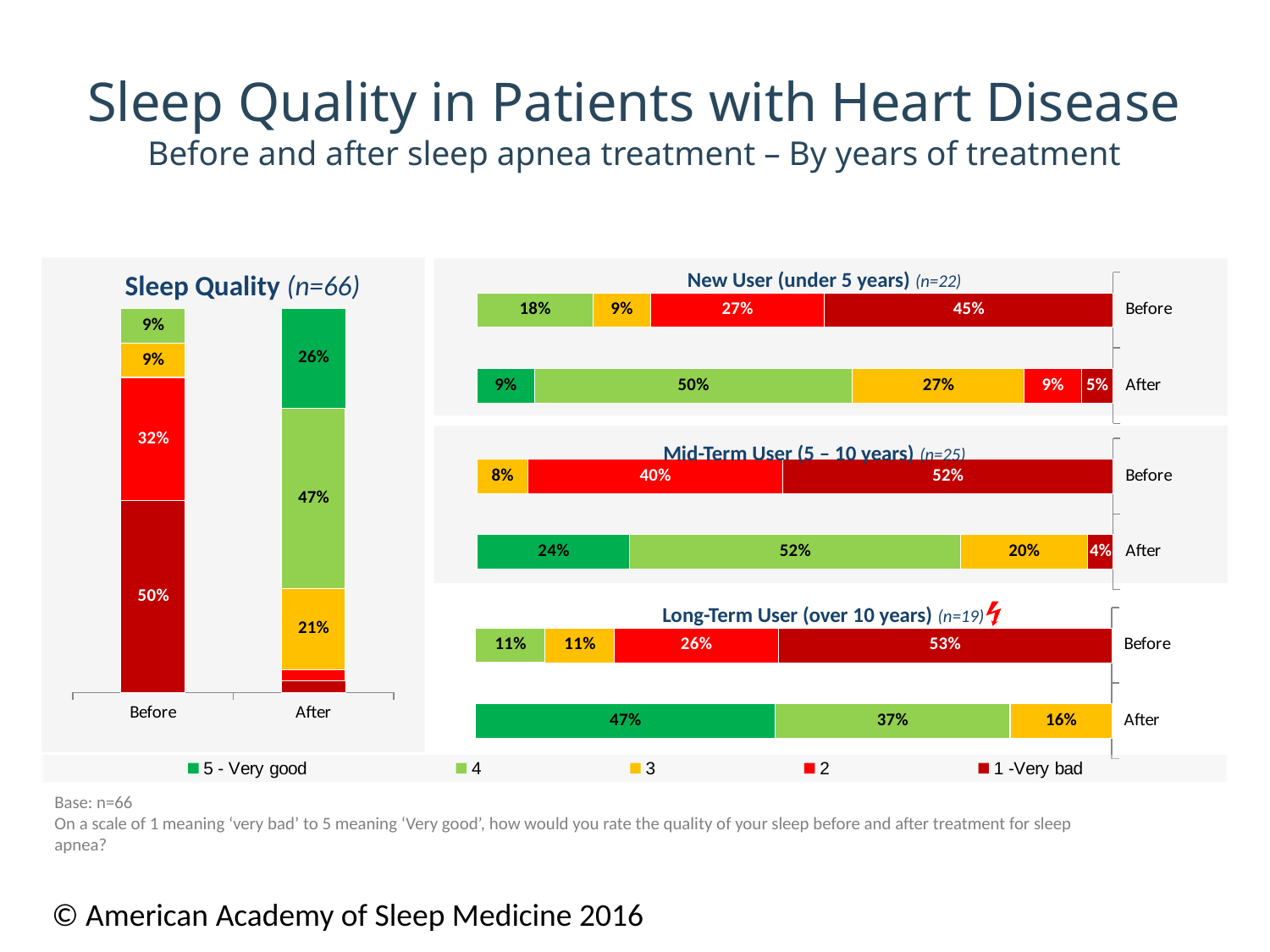
In the Mid-Term User (5 – 10 years) chart, which rating has the largest share in the Before bar? 1 - Very bad In the Sleep Quality (n=66) chart, what is the difference between the '2' rating before treatment and the '3' rating after treatment? 11% In the Long-Term User (over 10 years) chart, is the '1 - Very bad' share before treatment larger or smaller than the '2' share before treatment? larger In the New User (under 5 years) chart, what percentage rated their sleep '4' after treatment? 50% In the Mid-Term User (5 – 10 years) chart, what percentage rated their sleep '5 - Very good' after treatment? 24% In the Sleep Quality (n=66) chart, what percentage of patients rated their sleep '5 - Very good' after treatment? 26% What is the sample size shown in the title of the Long-Term User chart? n=19 In the Long-Term User (over 10 years) chart, what percentage rated their sleep '5 - Very good' after treatment? 47% In the New User (under 5 years) chart, what percentage rated their sleep '1 - Very bad' before treatment? 45% In the Sleep Quality (n=66) chart, what percentage of patients rated their sleep '1 - Very bad' before treatment? 50% What kind of chart is the Sleep Quality (n=66) chart? Stacked bar chart How many series does the legend at the bottom of the slide list? 5